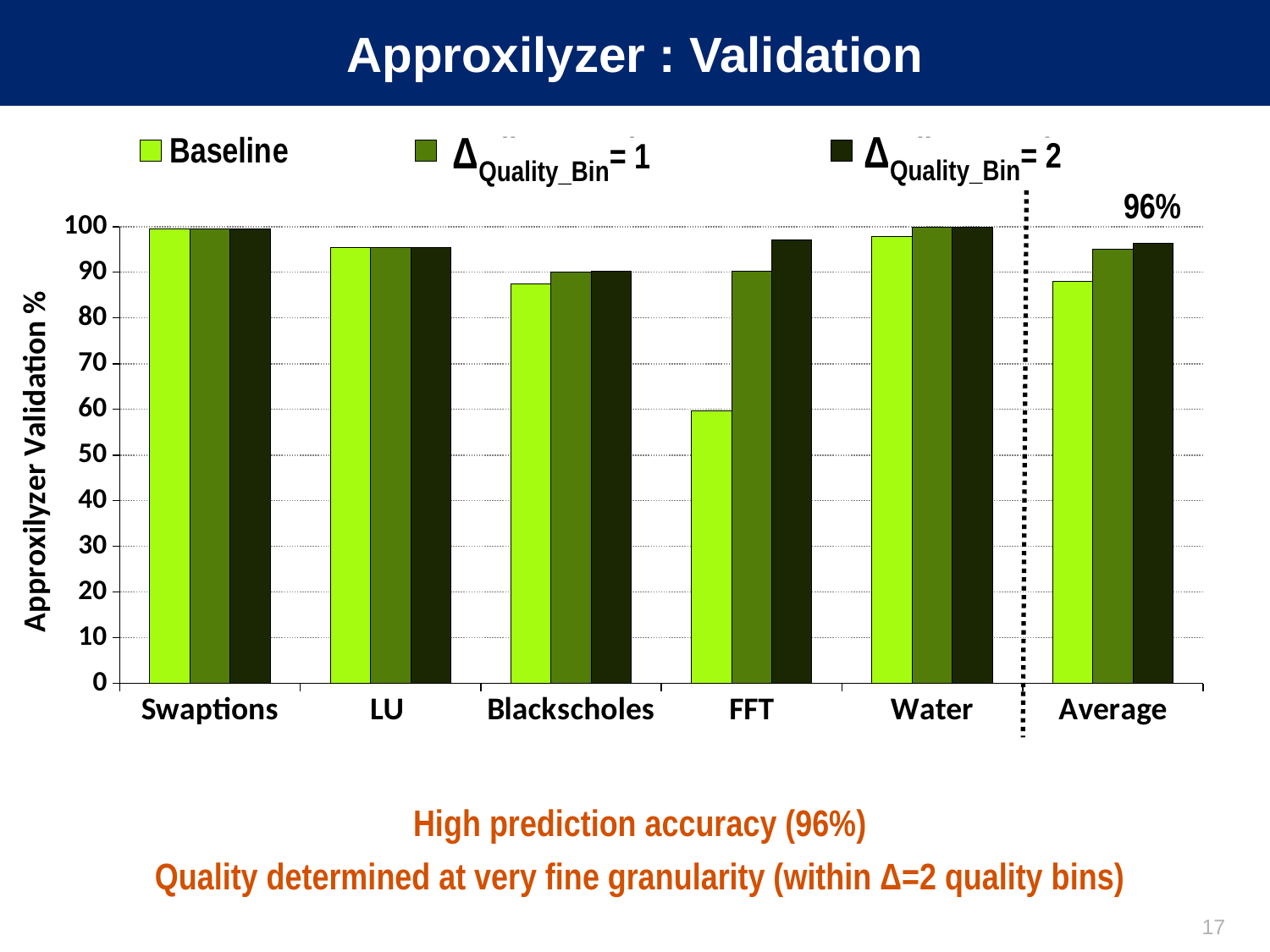
Which category is separated from the others by a dotted vertical line? Average What is the label of the y axis of the chart? Approxilyzer Validation % Is the Baseline value for FFT greater or less than 70? less Which category has the lowest Baseline value? FFT How many series does the chart's legend list? 3 Is the Baseline value for Blackscholes greater or less than 80? greater Which is larger, the Baseline value for FFT or the Baseline value for Water? Water Is the Baseline value for Swaptions greater or less than 90? greater What value is labelled for the Average category with ΔQuality_Bin = 2? 96% How many categories are shown on the x axis of the chart? 6 What kind of chart is shown on the slide? bar chart Which is larger for FFT, the Baseline value or the ΔQuality_Bin = 2 value? ΔQuality_Bin = 2